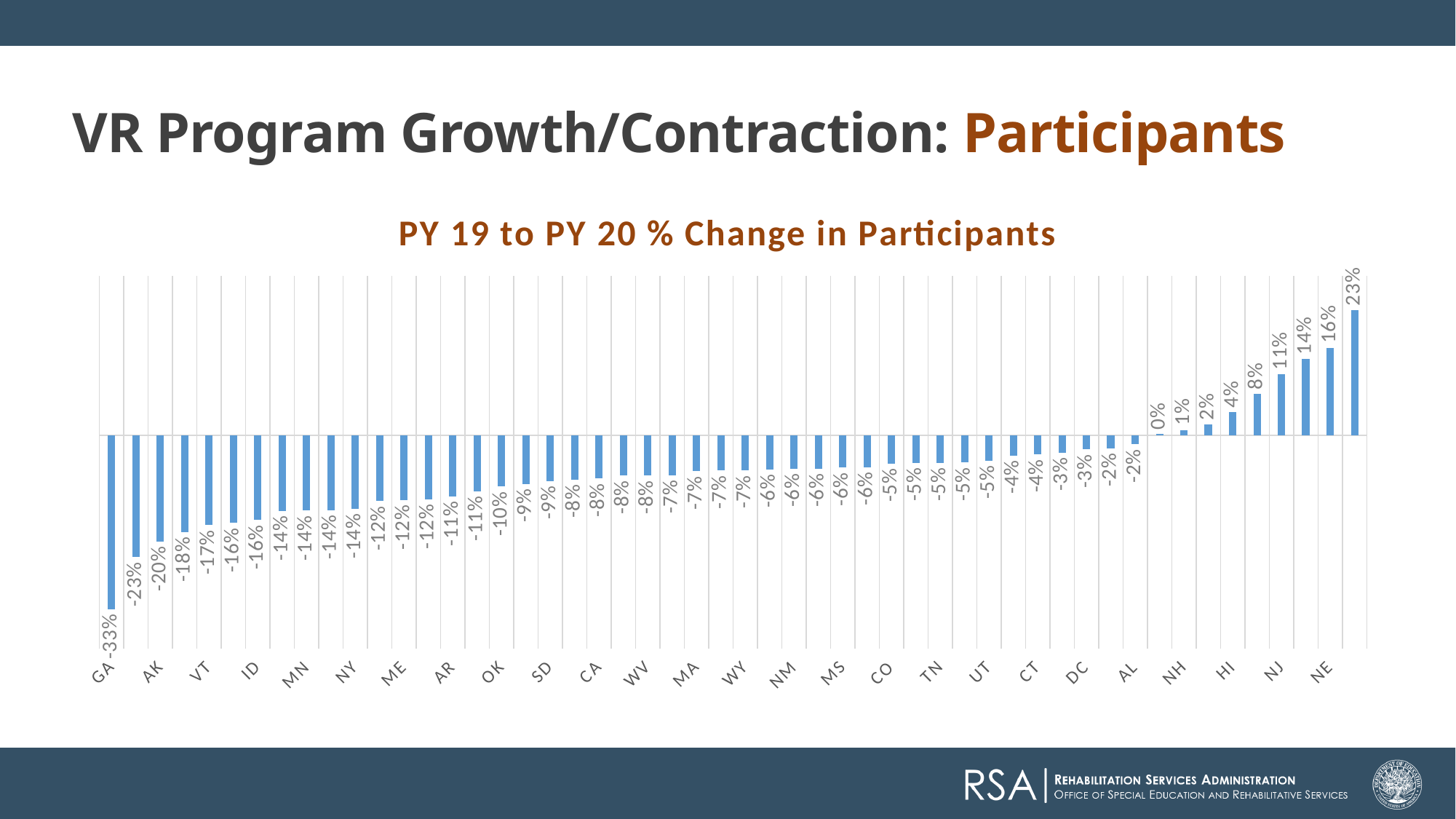
What is the value for NE? 16% What kind of chart is shown on the slide? Bar chart What is the highest value shown on the chart? 23% What is the value for GA? -33% What is the difference between the values for AK and GA? 13 percentage points What is the value for HI? 4% Which state has the lowest % change in participants? GA Which is larger, the value for NJ or the value for HI? NJ What is the value for NJ? 11% What is the value for AK? -20% Do the values rise or fall moving from left to right along the x axis? Rise What is the title of the chart? PY 19 to PY 20 % Change in Participants